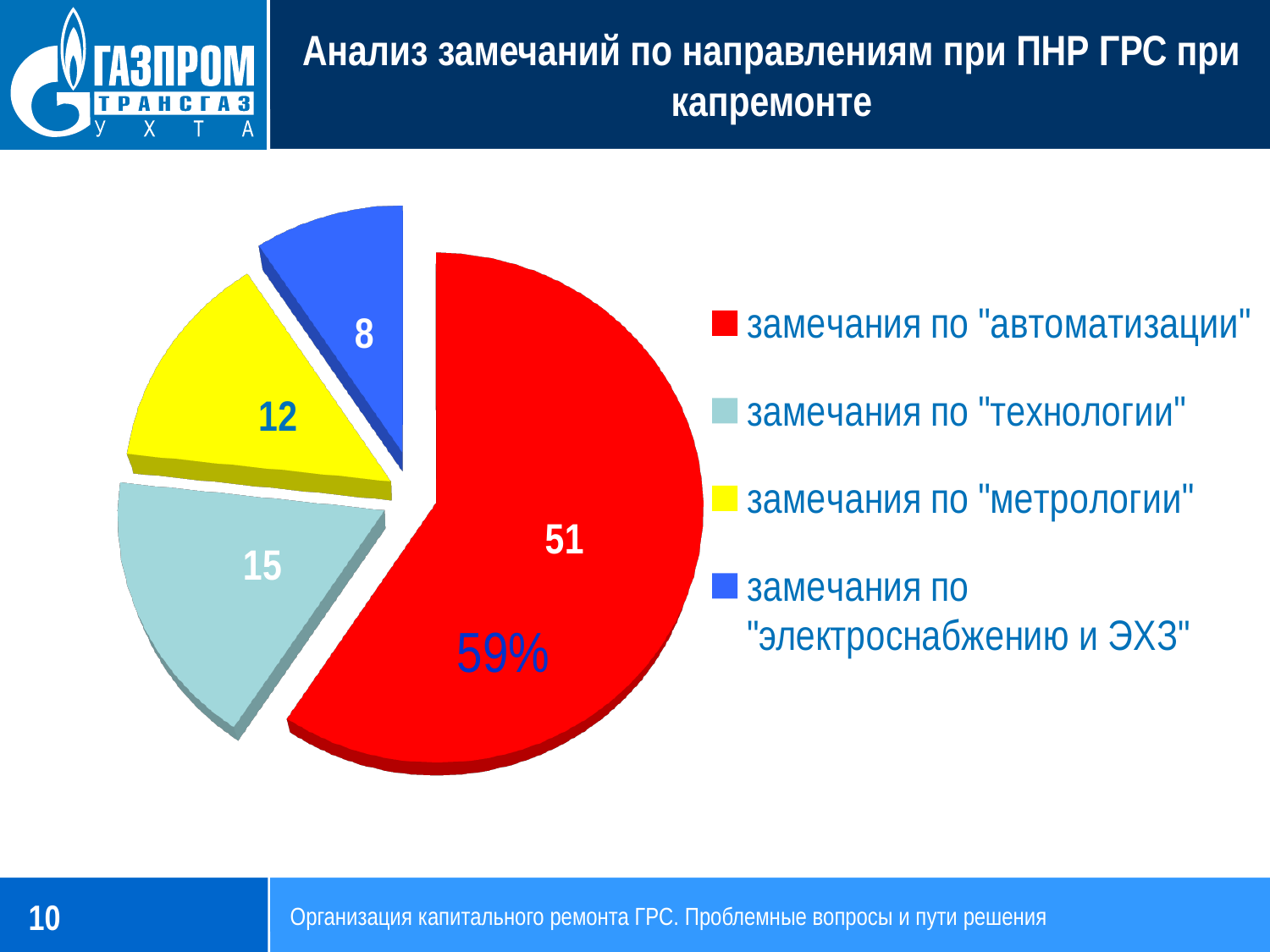
Which is larger: the value for "замечания по "метрологии"" or for "замечания по "электроснабжению и ЭХЗ""? замечания по "метрологии" What percentage share of the pie is labelled on the "замечания по "автоматизации"" slice? 59% How many slices does the pie chart have? 4 What value is shown for the slice "замечания по "метрологии""? 12 What value is shown for the slice "замечания по "технологии""? 15 What is the difference between the values for "замечания по "автоматизации"" and "замечания по "технологии""? 36 Which category has the smallest slice of the pie? замечания по "электроснабжению и ЭХЗ" What value is shown for the slice "замечания по "автоматизации""? 51 Which category has the largest slice of the pie? замечания по "автоматизации" What value is shown for the slice "замечания по "электроснабжению и ЭХЗ""? 8 What type of chart is shown on the slide? pie chart What colour is the slice for "замечания по "метрологии""? yellow